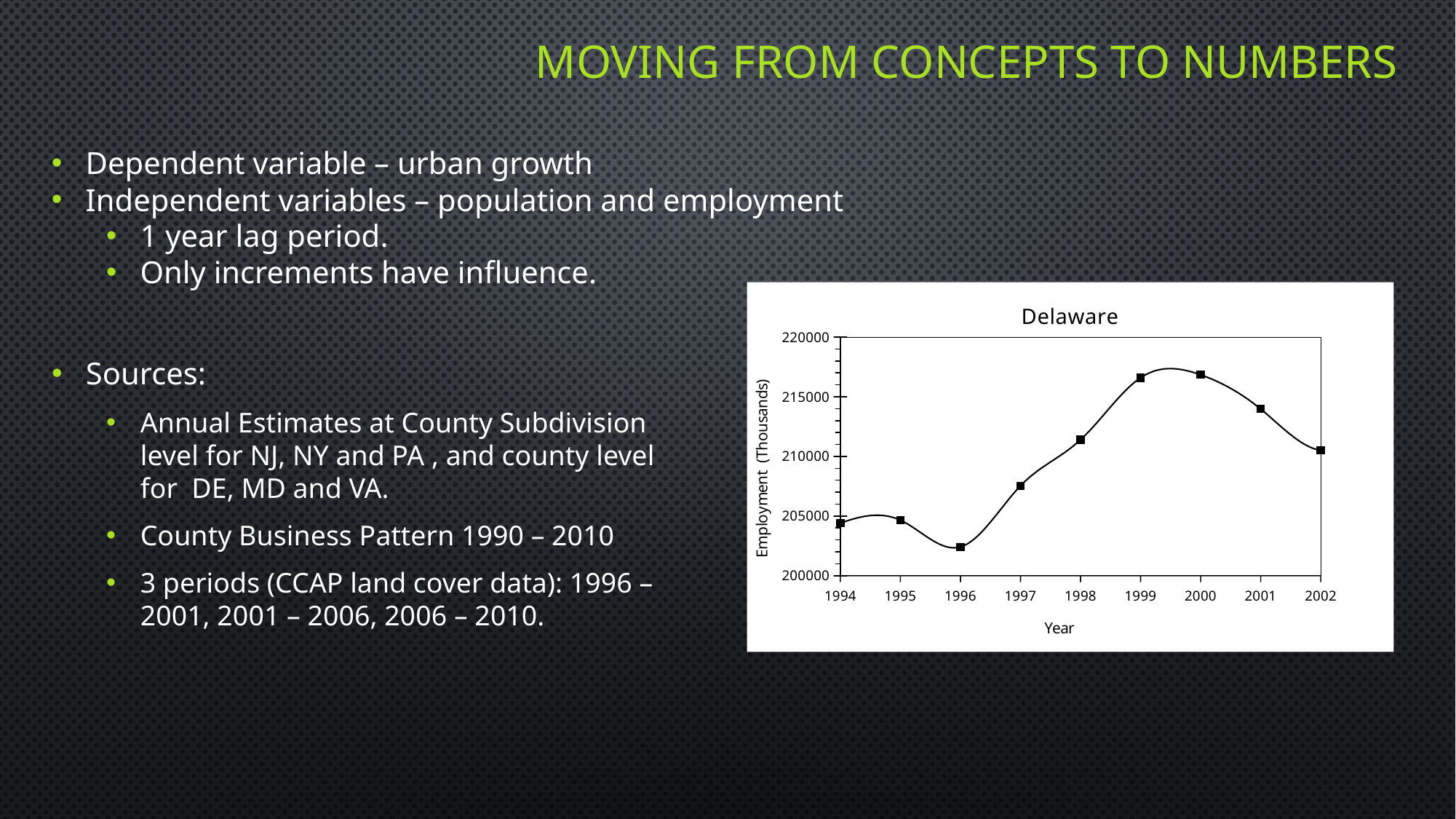
What kind of chart is shown on the slide? line chart Is the value for 1999 greater or less than 215000? greater Which year has the lowest employment value on the chart? 1996 Is the value for 2001 greater or less than 215000? less Which year has the larger employment value, 1997 or 1998? 1998 Which year has the larger employment value, 2001 or 2002? 2001 Is the value for 1998 greater or less than 210000? greater Do the employment values rise or fall from 2000 to 2002? fall How many data points are plotted on the chart? 9 What is the title of the chart? Delaware What is the label of the y axis of the chart? Employment (Thousands)